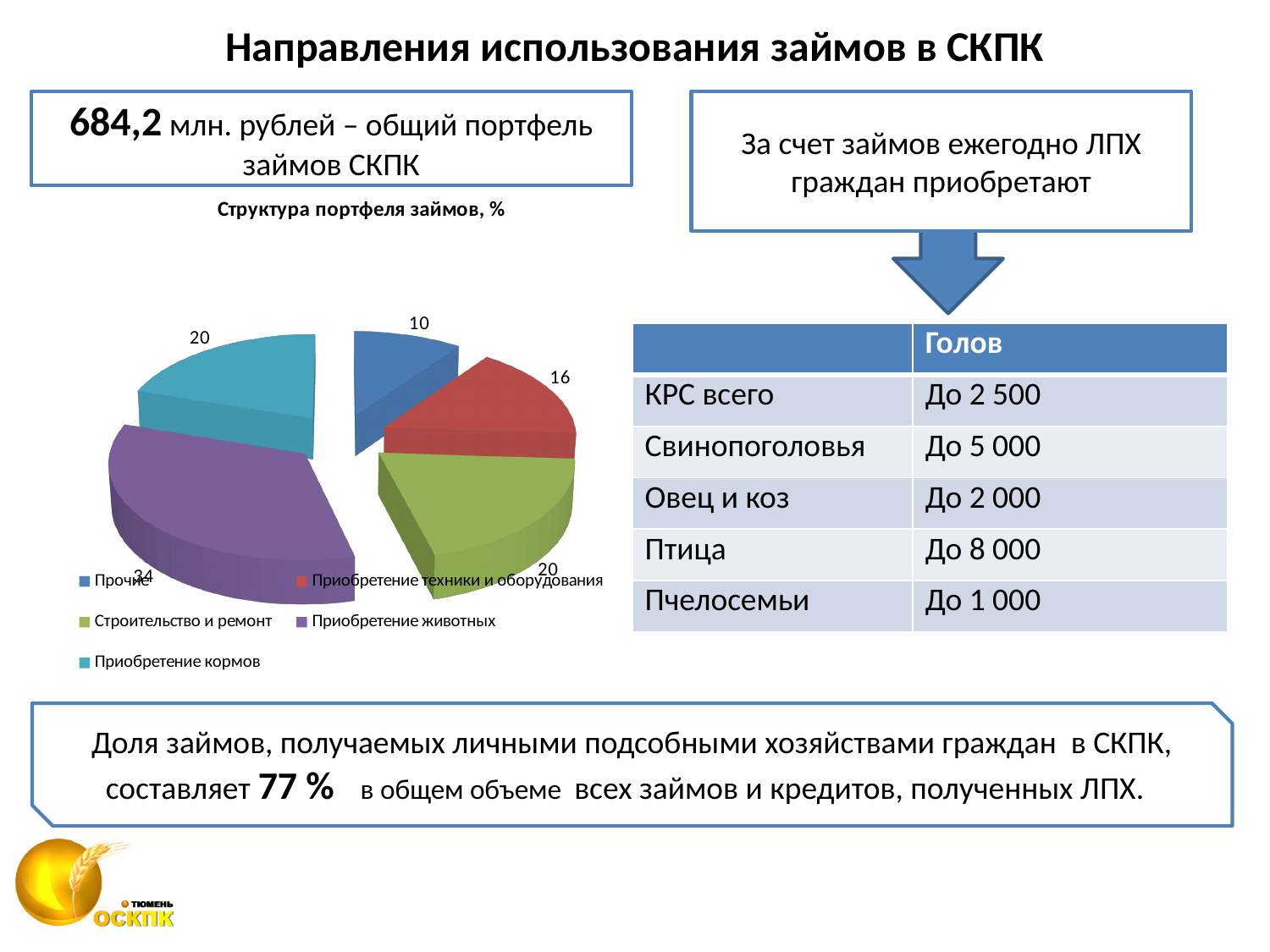
Which category has the smallest slice of the pie? Прочие Which is larger: Строительство и ремонт or Приобретение техники и оборудования? Строительство и ремонт What is the value for Прочие? 10 What is the title of the chart? Структура портфеля займов, % Which category has the largest slice of the pie? Приобретение животных What is the value for Приобретение животных? 34 How many entries does the chart legend list? 5 How many slices does the pie chart have? 5 What is the value for Приобретение кормов? 20 What is the value for Приобретение техники и оборудования? 16 What kind of chart is shown on the slide? Pie chart What is the difference between the values for Приобретение животных and Прочие? 24